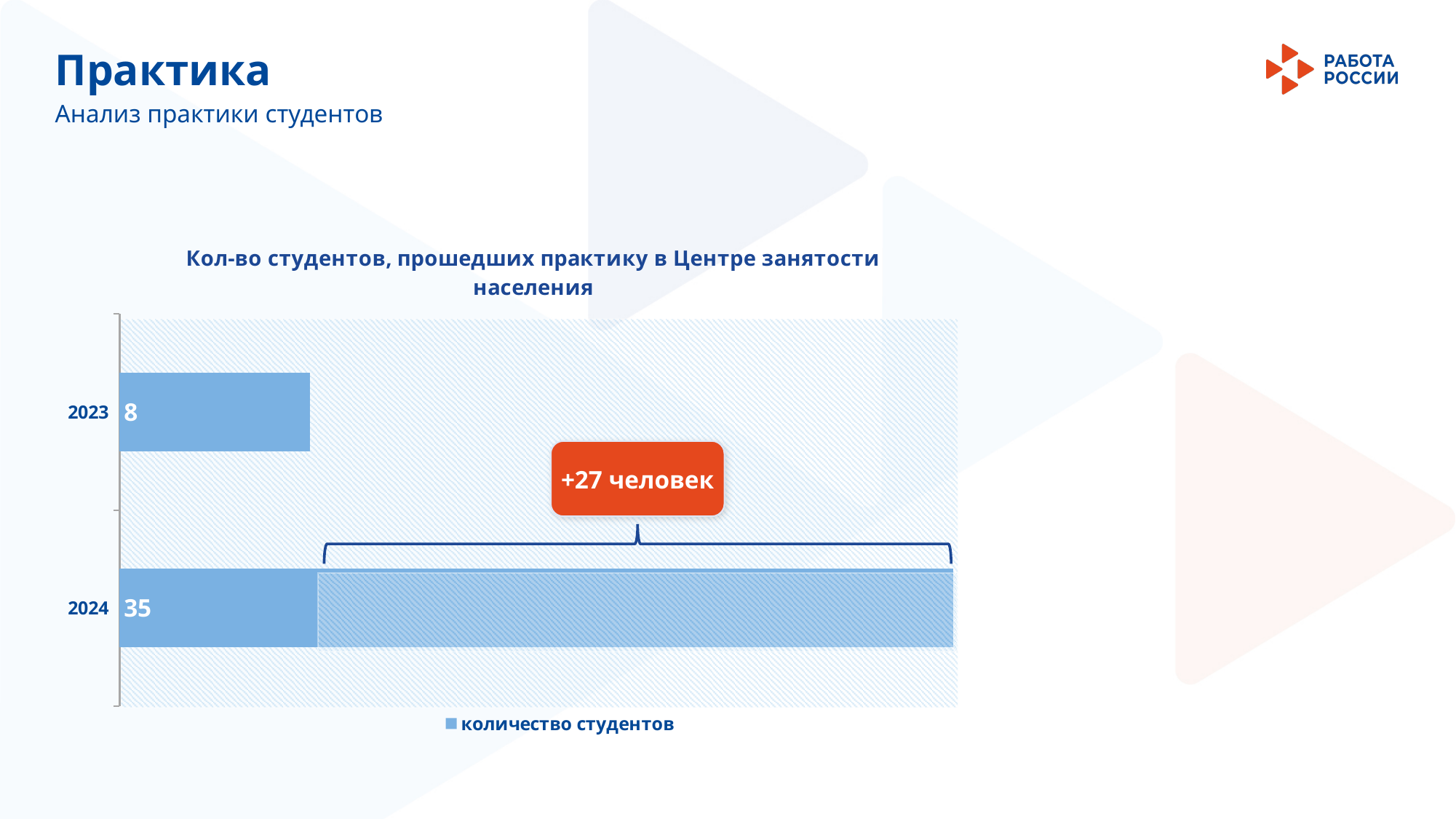
Which year has the lowest number of students? 2023 What kind of chart is shown on the slide? bar chart Does the number of students rise or fall from 2023 to 2024? rise How many categories are shown on the chart? 2 What is the value for 2023? 8 What is the value for 2024? 35 What is the title of the chart? Кол-во студентов, прошедших практику в Центре занятости населения What is the name of the series in the legend? количество студентов How many series does the legend list? 1 What is the difference between the values for 2024 and 2023? 27 Which year has the highest number of students? 2024 Which is larger, the value for 2023 or the value for 2024? 2024